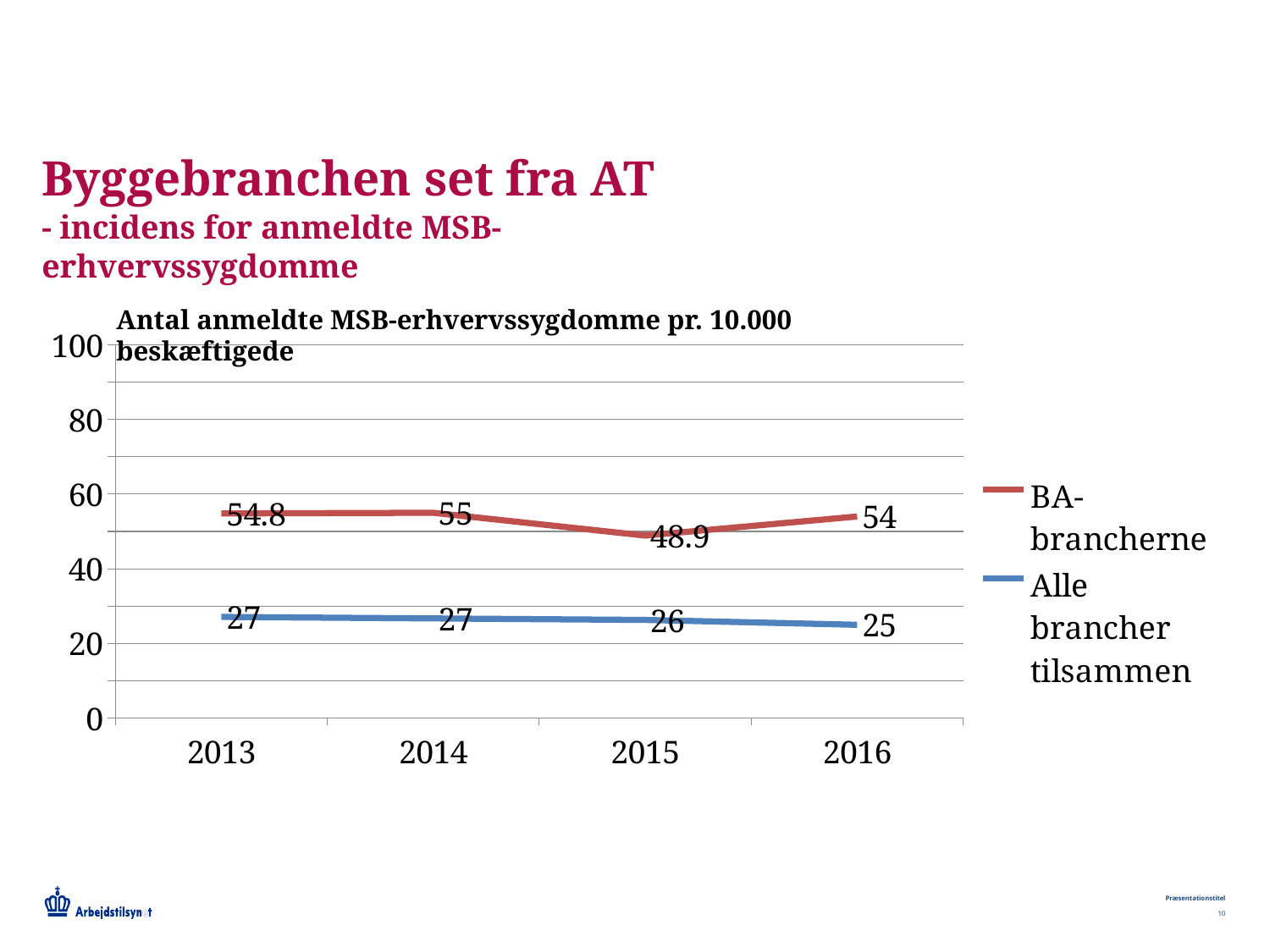
What is the difference between the BA-brancherne values for 2014 and 2015? 6.1 What is the value for BA-brancherne in 2013? 54.8 Which series has the larger value in 2014, BA-brancherne or Alle brancher tilsammen? BA-brancherne In which year is the value for BA-brancherne highest? 2014 Is the value for BA-brancherne in 2016 greater or less than 40? greater How many series does the legend list? 2 In which year is the value for BA-brancherne lowest? 2015 What is the difference between BA-brancherne and Alle brancher tilsammen in 2016? 29 How many years are shown on the x axis? 4 What is the value for Alle brancher tilsammen in 2016? 25 What kind of chart is shown on the slide? Line chart What is the value for BA-brancherne in 2015? 48.9